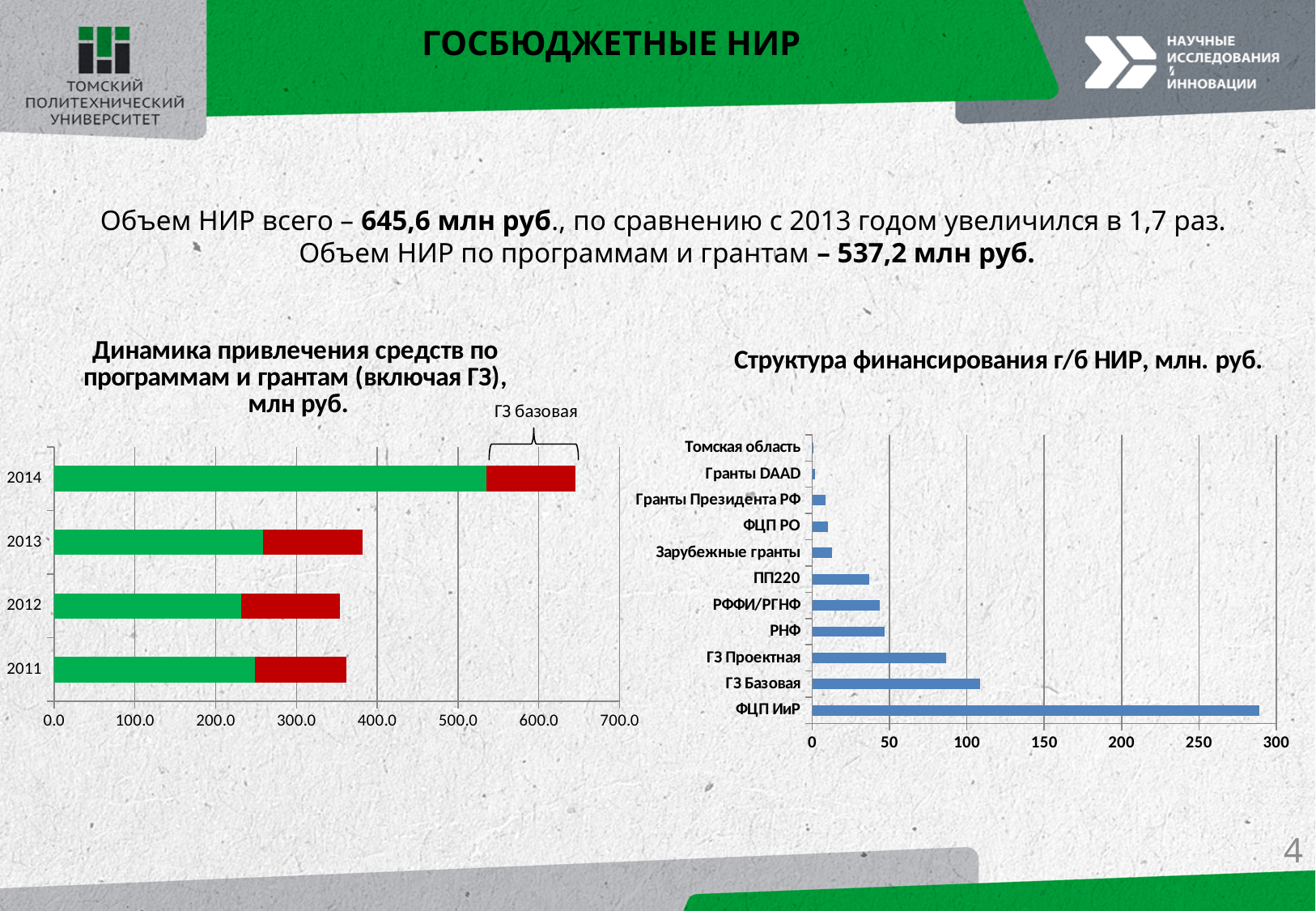
On the chart titled 'Структура финансирования г/б НИР, млн. руб.', is the value for ПП220 greater or less than 50? less What kind of chart is the one titled 'Структура финансирования г/б НИР, млн. руб.'? bar chart On the chart titled 'Структура финансирования г/б НИР, млн. руб.', which is larger: ГЗ Проектная or РНФ? ГЗ Проектная On the chart titled 'Структура финансирования г/б НИР, млн. руб.', how many categories are shown? 11 On the left chart ('Динамика привлечения средств по программам и грантам'), how many years are shown? 4 On the left chart ('Динамика привлечения средств по программам и грантам'), which year has the highest total? 2014 On the left chart ('Динамика привлечения средств по программам и грантам'), is the total for 2013 greater or less than 400? less On the chart titled 'Структура финансирования г/б НИР, млн. руб.', is the value for ГЗ Базовая greater or less than 100? greater On the chart titled 'Структура финансирования г/б НИР, млн. руб.', which category has the highest value? ФЦП ИиР On the chart titled 'Структура финансирования г/б НИР, млн. руб.', which category has the lowest value? Томская область